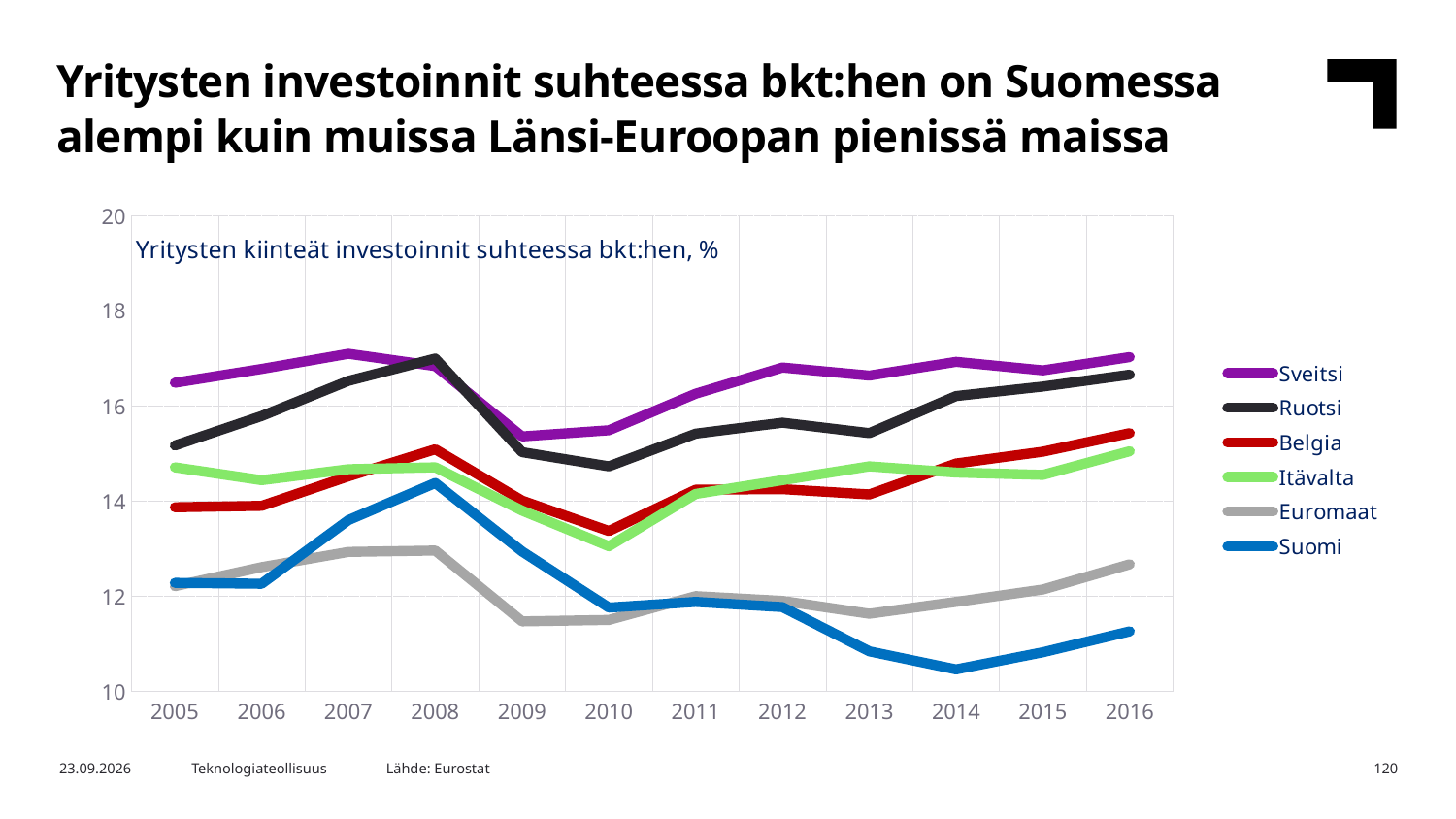
What is the subtitle printed inside the chart area? Yritysten kiinteät investoinnit suhteessa bkt:hen, % Which series has the highest value in 2012? Sveitsi How many series does the legend list? 6 In 2008, which is larger, the value for Ruotsi or the value for Belgia? Ruotsi Is the value for Sveitsi in 2007 greater or less than 16? greater Does the value for Suomi rise or fall from 2008 to 2014? fall Is the value for Suomi in 2014 greater or less than 12? less Which country has the lowest value in 2016? Suomi How many years are shown on the x axis? 12 Which series has the lowest value in 2009? Euromaat Is the value for Ruotsi in 2010 greater or less than 16? less What kind of chart is shown on the slide? line chart